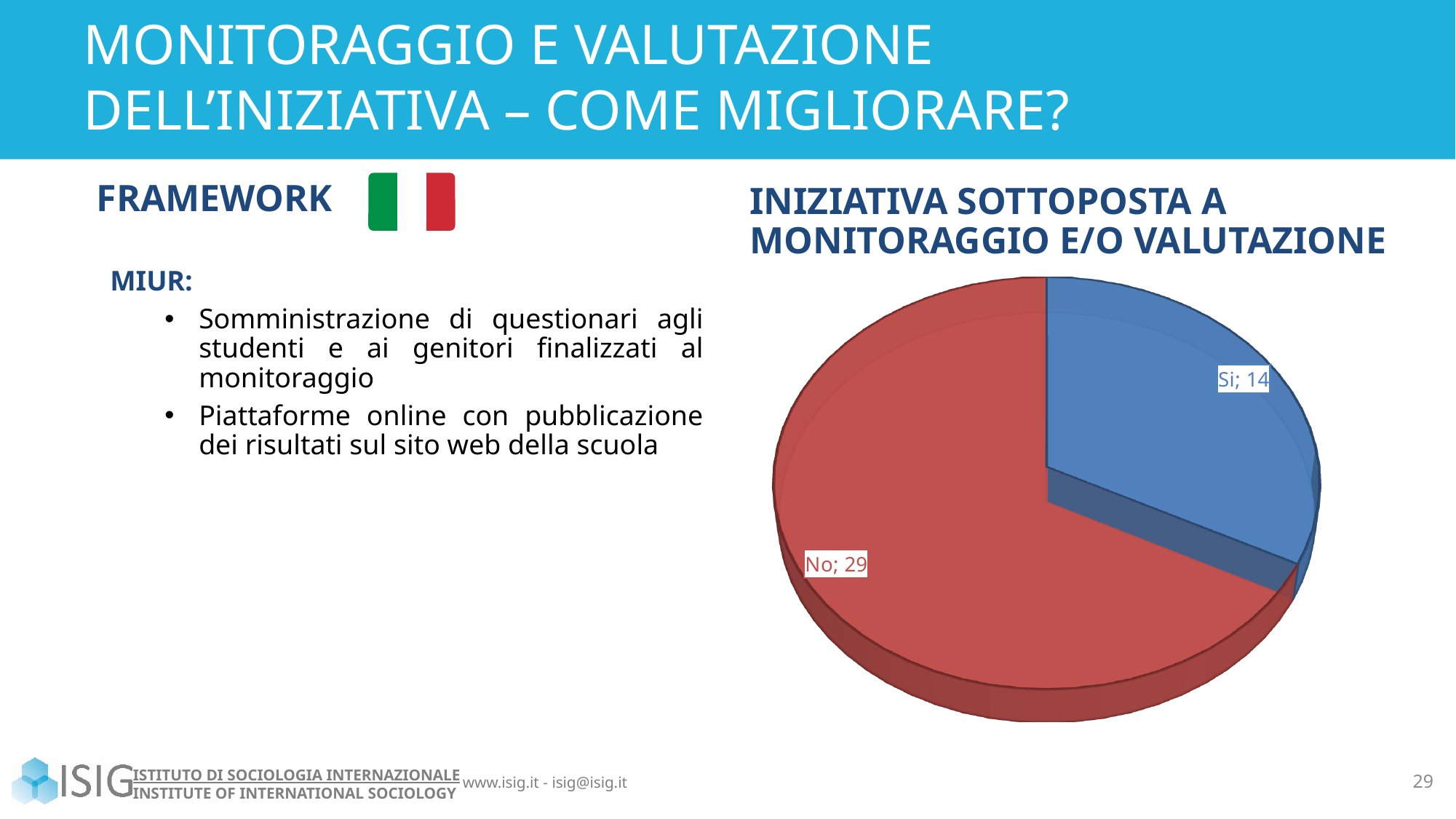
What is the value for the "Si" slice? 14 What colour is the "No" slice? Red What is the value for the "No" slice? 29 What is the title of the pie chart? INIZIATIVA SOTTOPOSTA A MONITORAGGIO E/O VALUTAZIONE How many slices does the pie chart have? 2 What type of chart is shown on the slide? Pie chart What is the total of all slices in the pie chart? 43 Which slice has the lowest value? Si Which is larger, the value for "Si" or the value for "No"? No What is the difference between the "No" and "Si" values? 15 Which slice has the highest value? No